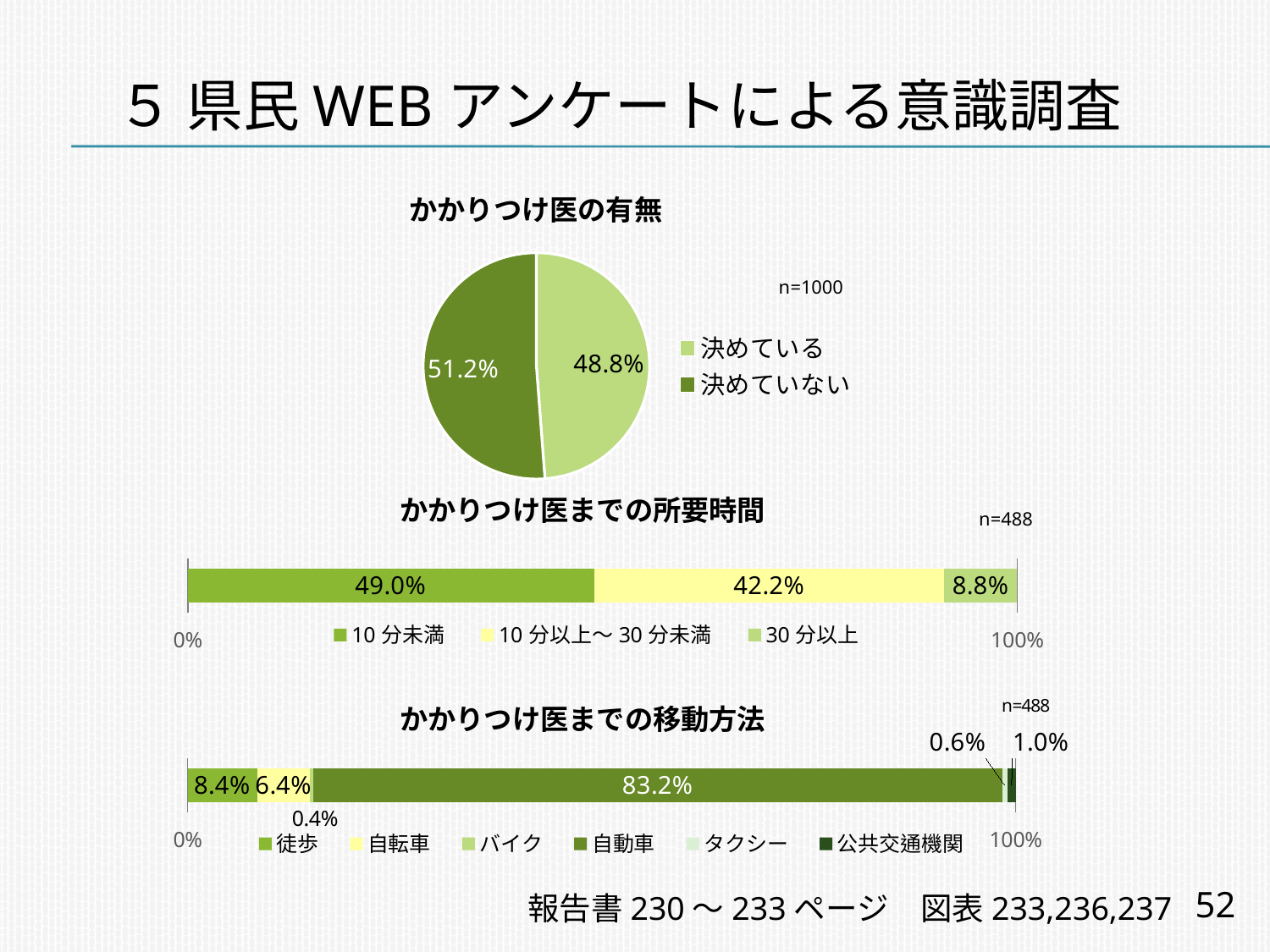
In the chart かかりつけ医までの移動方法, what percentage is 徒歩? 8.4% In the chart かかりつけ医までの所要時間, what percentage is 10分未満? 49.0% How many series does the legend of the chart かかりつけ医までの移動方法 list? 6 In the chart かかりつけ医までの所要時間, what percentage is 30分以上? 8.8% In the pie chart かかりつけ医の有無, what percentage is 決めていない? 51.2% How many series does the legend of the chart かかりつけ医までの所要時間 list? 3 In the pie chart かかりつけ医の有無, which slice is larger, 決めている or 決めていない? 決めていない In the chart かかりつけ医までの所要時間, which category has the highest percentage? 10分未満 In the pie chart かかりつけ医の有無, what is the difference between 決めていない and 決めている? 2.4% In the pie chart かかりつけ医の有無, what percentage is 決めている? 48.8% What kind of chart is かかりつけ医の有無? Pie chart In the chart かかりつけ医までの移動方法, what percentage is 自動車? 83.2%